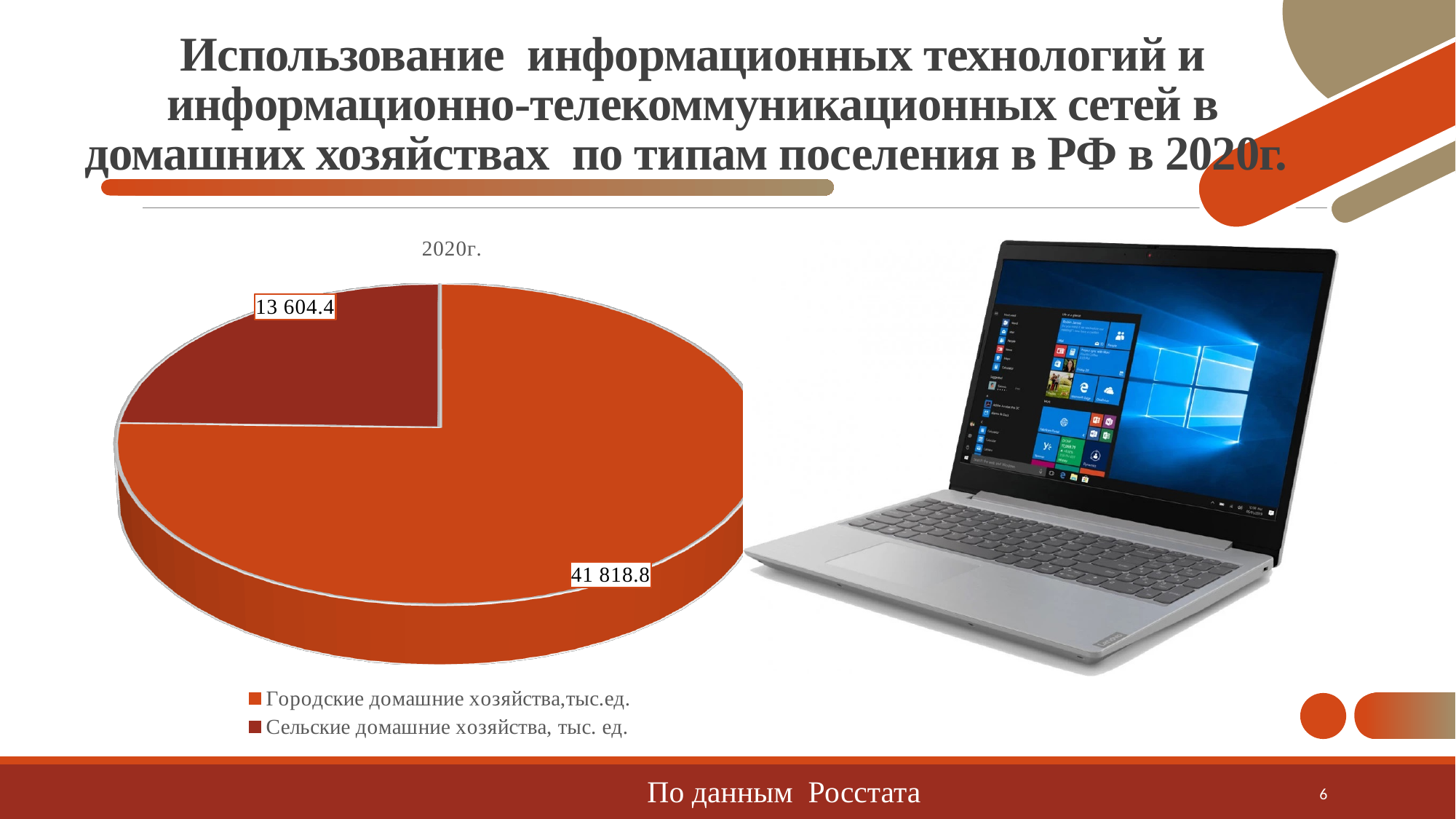
What is the value for Городские домашние хозяйства in the pie chart? 41 818.8 Which category has the largest slice in the pie chart? Городские домашние хозяйства What is the title shown above the pie chart? 2020г. What is the total of the two values shown in the pie chart? 55 423.2 What type of chart is shown on the slide? Pie chart What is the difference between the values for Городские домашние хозяйства and Сельские домашние хозяйства? 28 214.4 How many entries does the legend list? 2 What is the value for Сельские домашние хозяйства in the pie chart? 13 604.4 How many slices does the pie chart have? 2 Which category has the smallest slice in the pie chart? Сельские домашние хозяйства Which is larger: the value for Городские домашние хозяйства or for Сельские домашние хозяйства? Городские домашние хозяйства